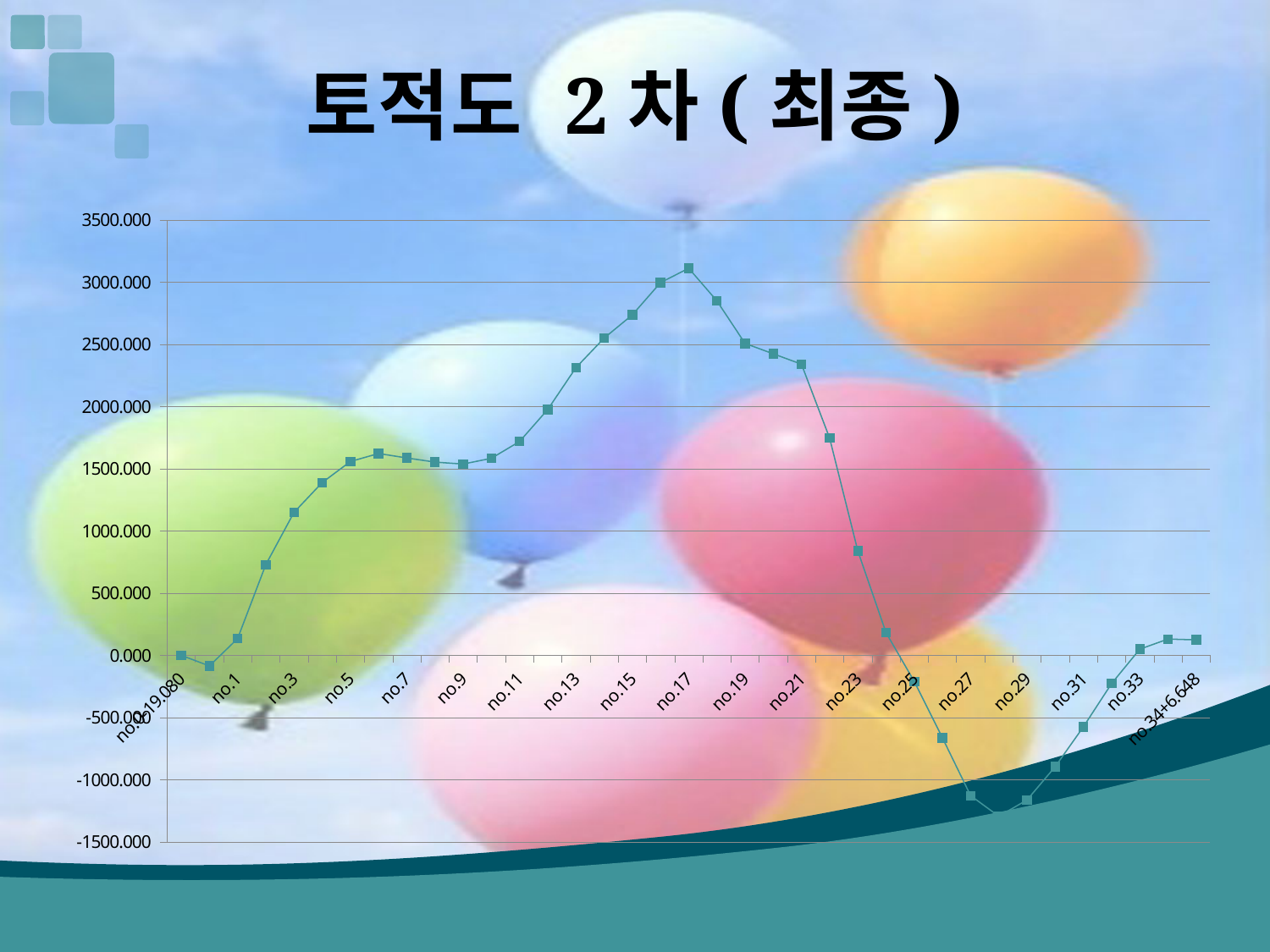
What is the title of the chart? 토적도 2차 (최종) Does the line rise or fall between no.17 and no.27? fall At which labeled station does the line reach its highest value? no.17 Is the value at no.27 greater or less than -500? less Which is larger, the value at no.17 or the value at no.9? no.17 What is the highest value shown on the vertical axis? 3500.000 Is the value at no.17 greater or less than 2500? greater What kind of chart is shown on the slide? line chart Is the value at no.23 greater or less than 1000? less